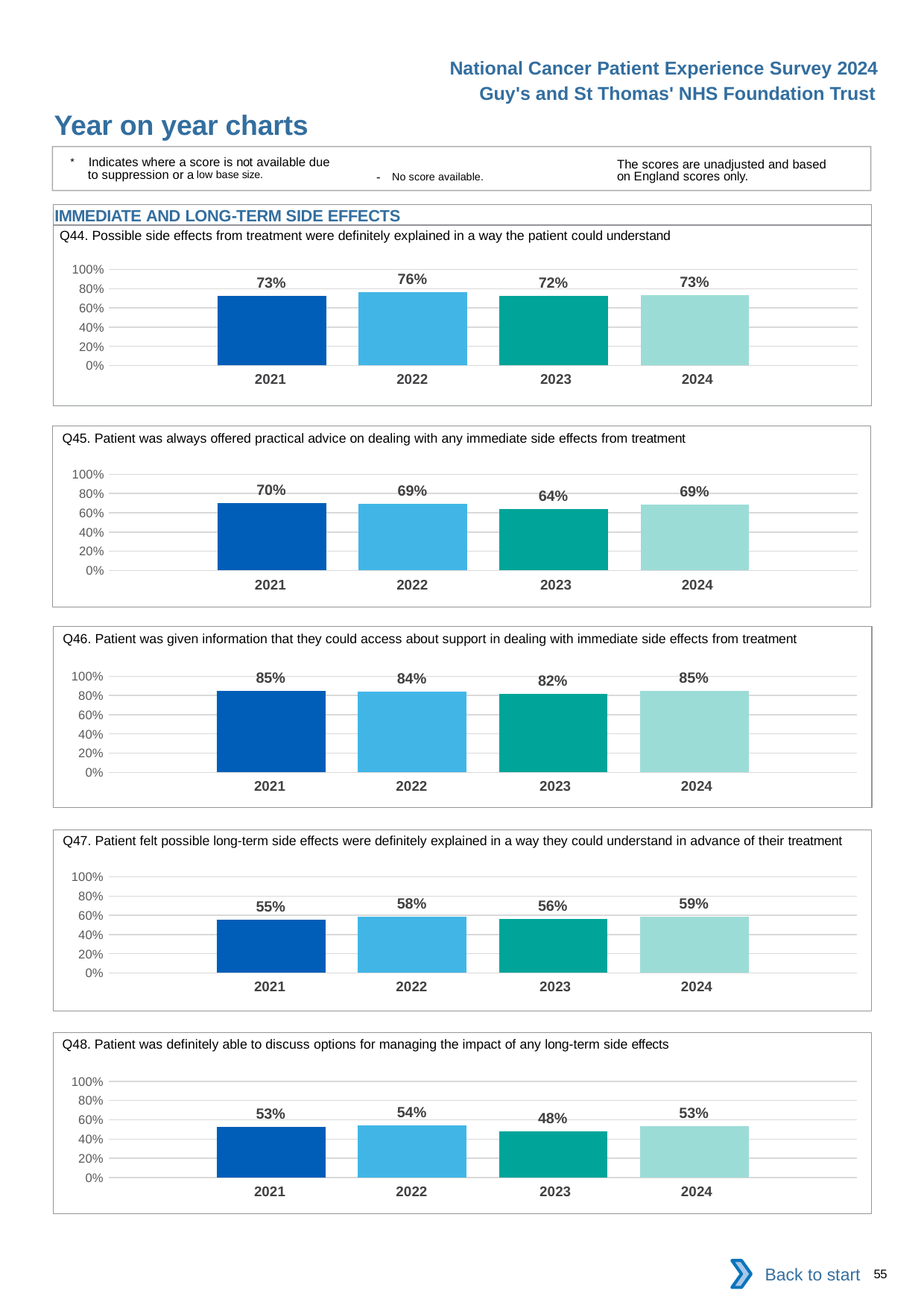
In the Q47 chart, which year has the highest value? 2024 In the Q46 chart, what is the difference between the 2021 value and the 2023 value? 3% How many charts are shown on the slide? 5 In the Q47 chart, is the value for 2021 greater or less than 60%? less In the Q44 chart, what is the value for 2022? 76% In the Q44 chart, which year has the lowest value? 2023 How many years are shown on the x axis of the Q44 chart? 4 In the Q45 chart, what is the difference between the 2021 value and the 2024 value? 1% In the Q48 chart, is the value for 2022 larger or smaller than the value for 2023? larger In the Q45 chart, which year has the lowest value? 2023 In the Q48 chart, what is the value for 2023? 48% What kind of chart is the Q45 chart? bar chart